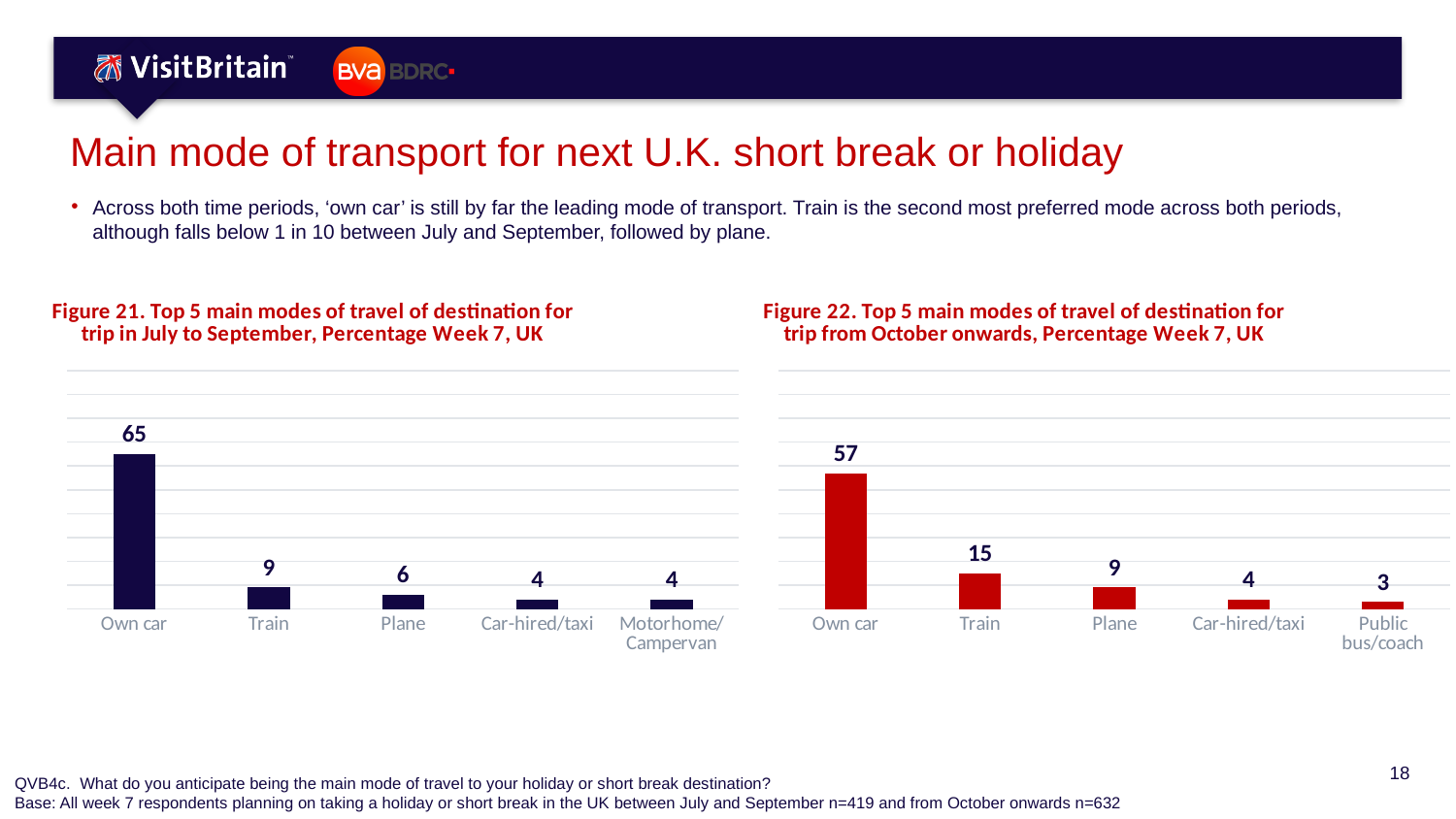
In Figure 21 (July to September), do the values rise or fall from left to right across the categories? Fall What colour are the bars in Figure 22 (October onwards)? Red In Figure 22 (October onwards), which mode of travel has the lowest value? Public bus/coach In Figure 21 (July to September), what is the difference between the values for Own car and Train? 56 What type of chart is Figure 22 (October onwards)? Bar chart In Figure 22 (October onwards), what is the value for Train? 15 In Figure 21 (July to September), which mode of travel has the lowest value? Car-hired/taxi and Motorhome/Campervan (both 4) In Figure 22 (October onwards), which mode of travel has the highest value? Own car Which is larger: the value for Plane in Figure 21 or the value for Plane in Figure 22? Figure 22 (9) In Figure 21 (July to September), what is the value for Own car? 65 How many modes of travel are shown in Figure 21 (July to September)? 5 In Figure 22 (October onwards), what is the difference between the values for Train and Plane? 6